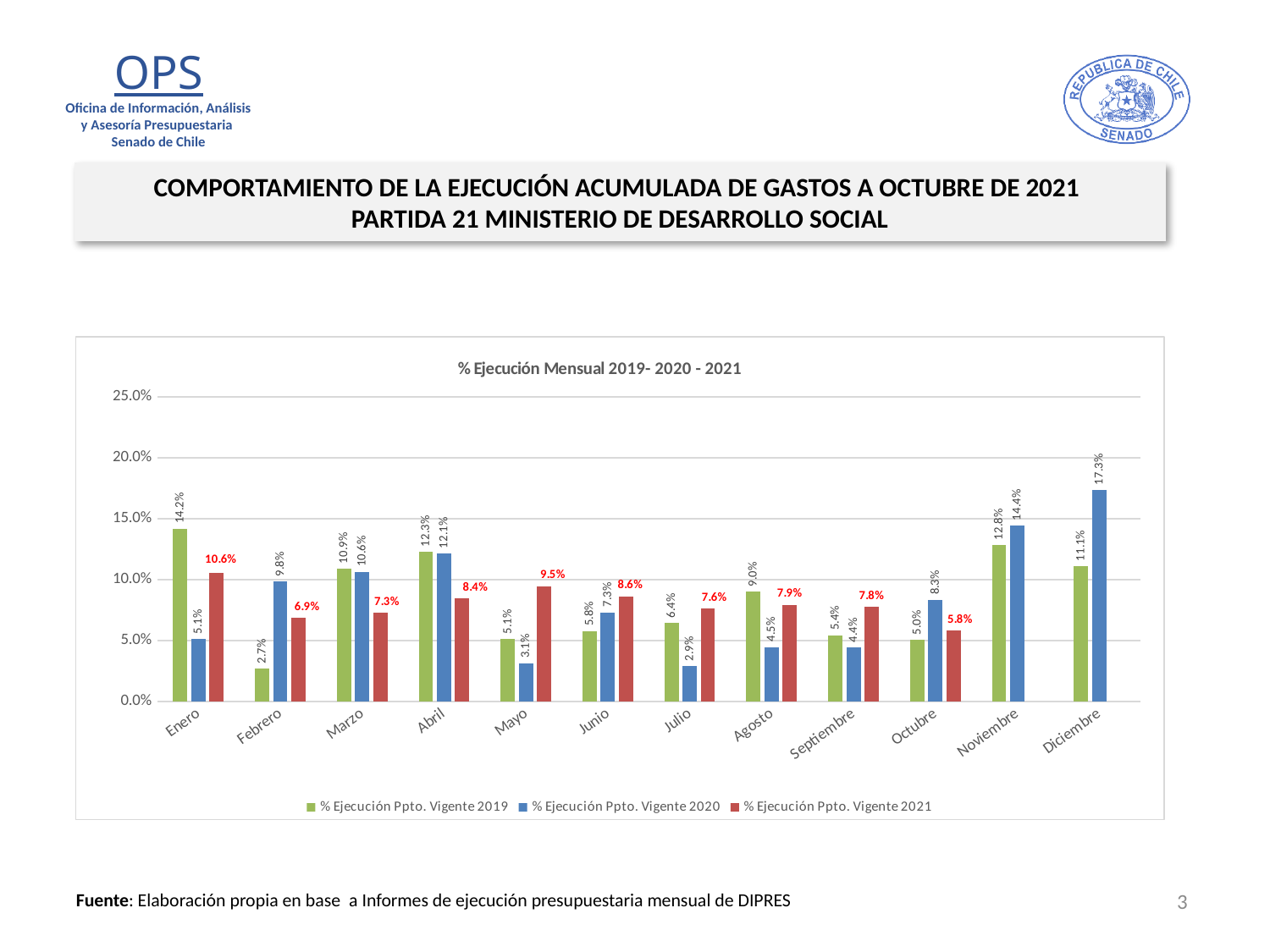
What is the difference between the 2019 and 2020 values in Enero? 9.1% How many series does the legend list? 3 How many months are shown on the x axis? 12 Which month has the lowest value for % Ejecución Ppto. Vigente 2019? Febrero What is the value for % Ejecución Ppto. Vigente 2019 in Abril? 12.3% What is the value for % Ejecución Ppto. Vigente 2021 in Enero? 10.6% What is the title of the chart? % Ejecución Mensual 2019- 2020 - 2021 Which month has the highest value for % Ejecución Ppto. Vigente 2020? Diciembre What is the value for % Ejecución Ppto. Vigente 2020 in Diciembre? 17.3% In Mayo, which is larger: the 2019 value or the 2021 value? 2021 Which month has the highest value for % Ejecución Ppto. Vigente 2021? Enero What type of chart is shown on the slide? bar chart